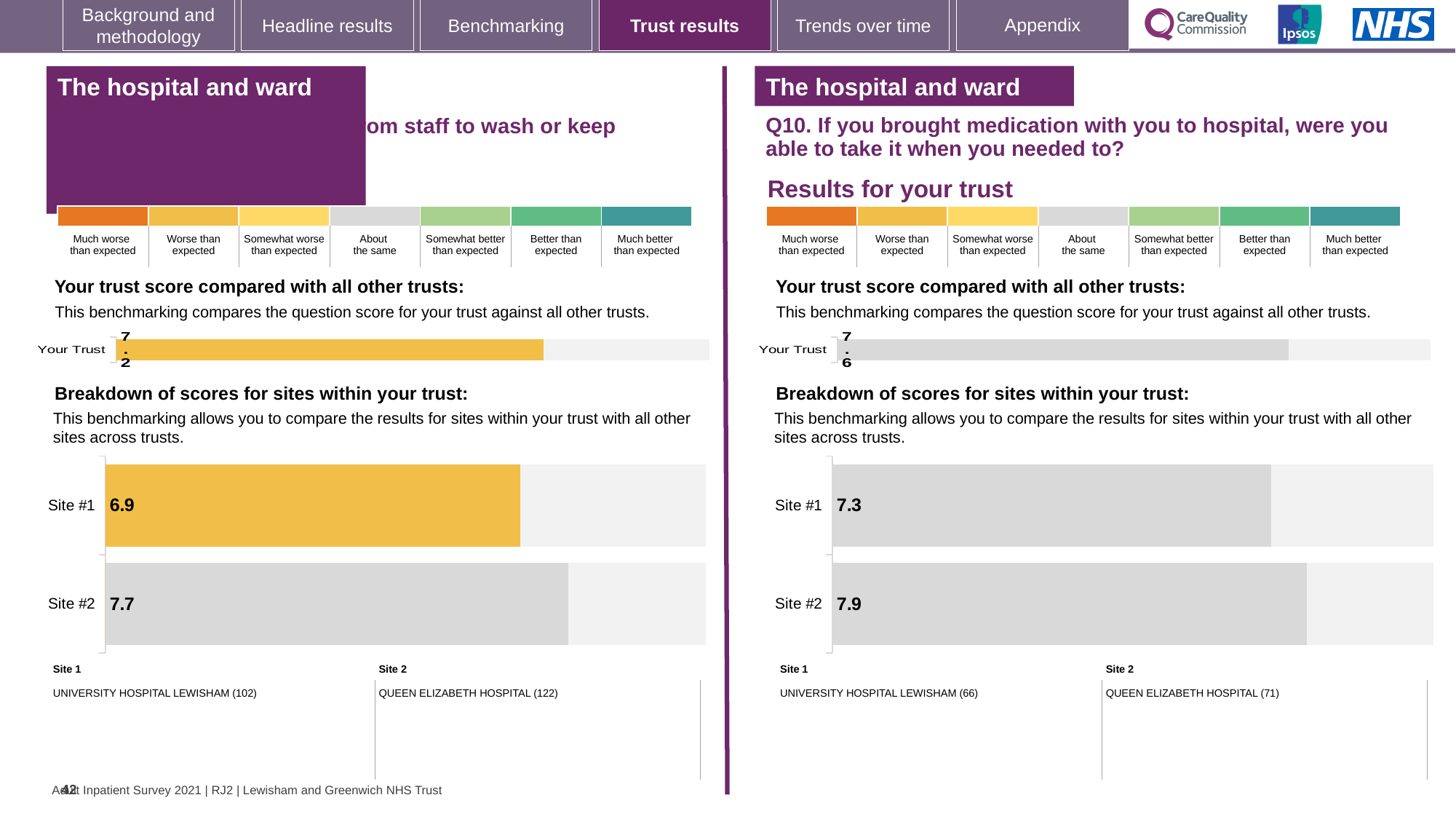
On the left-hand 'Your Trust' bar, what is the trust score shown? 7.2 On the right-hand chart for Q10, what is the difference between the Site #2 and Site #1 scores? 0.6 On the right-hand 'Your Trust' bar for Q10, what is the trust score shown? 7.6 On the right-hand chart for Q10 (medication brought to hospital), what is the score for Site #2? 7.9 On the left-hand site breakdown chart, what is the score for Site #1? 6.9 On the left-hand site breakdown chart, which site has the lower score? Site #1 What type of chart is used for the site breakdown on the right-hand side for Q10? Bar chart On the left-hand site breakdown chart, what is the score for Site #2? 7.7 On the right-hand chart for Q10 (medication brought to hospital), what is the score for Site #1? 7.3 How many sites are shown in the right-hand site breakdown chart for Q10? 2 On the right-hand chart for Q10, which site has the higher score? Site #2 On the left-hand site breakdown chart, what is the difference between the Site #2 and Site #1 scores? 0.8